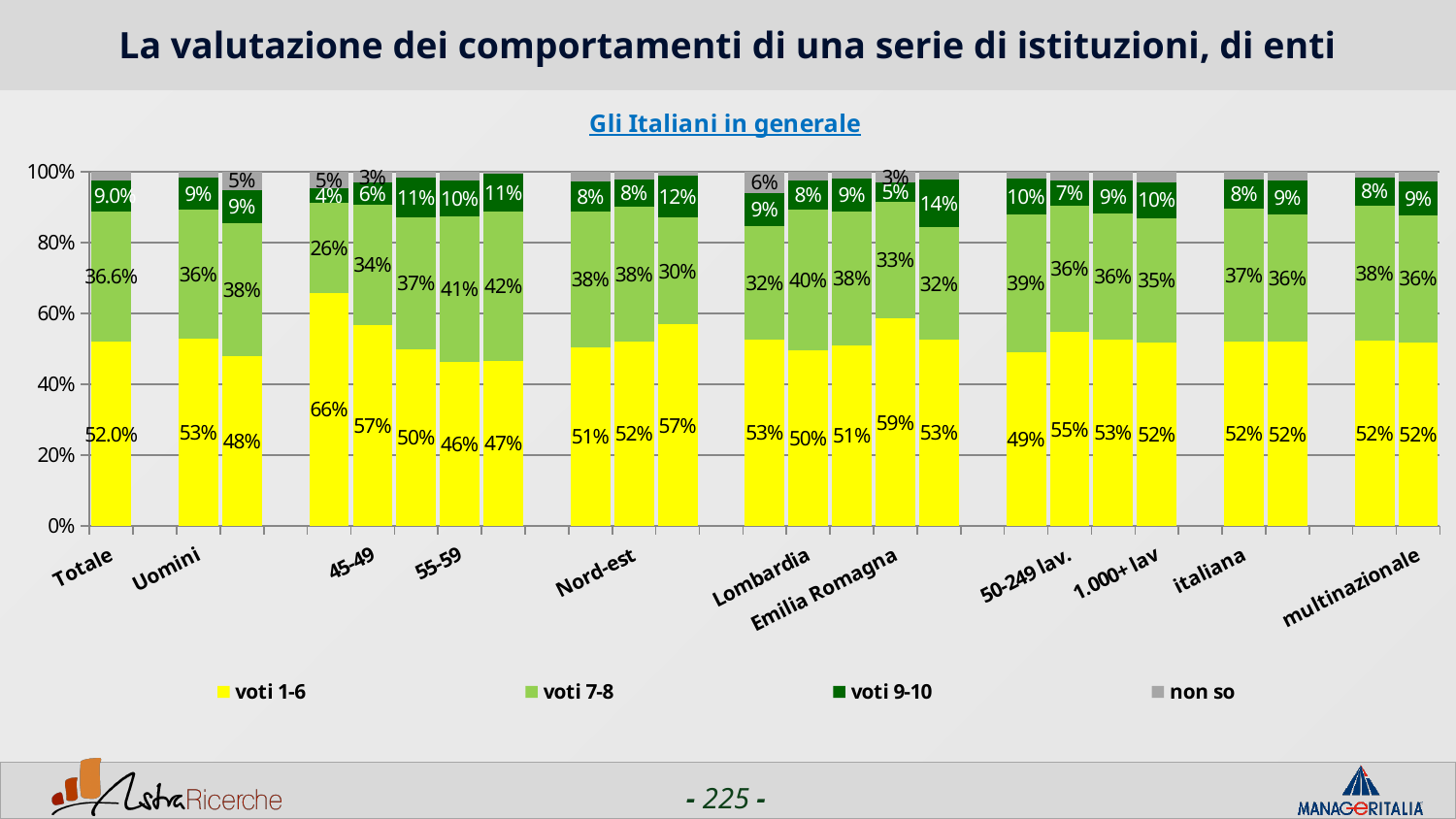
In the 'Totale' bar, which is larger: the 'voti 1-6' segment or the 'voti 7-8' segment? voti 1-6 In the 'Totale' bar, what is the difference between the 'voti 1-6' segment and the 'voti 7-8' segment? 15.4 percentage points What are the four legend entries of the chart? voti 1-6, voti 7-8, voti 9-10, non so What kind of chart is shown on the slide? Stacked bar chart What is the value of the 'voti 1-6' segment for 'Emilia Romagna'? 59% What is the value of the 'voti 1-6' segment for 'Uomini'? 53% What is the value of the 'voti 9-10' segment for the 'Totale' bar? 9.0% What is the value of the 'voti 1-6' segment for the 'Totale' bar? 52.0% What is the value of the 'voti 7-8' segment for '55-59'? 41% What is the subtitle shown above the chart? Gli Italiani in generale How many series does the legend list? 4 What is the value of the 'voti 7-8' segment for the 'Totale' bar? 36.6%